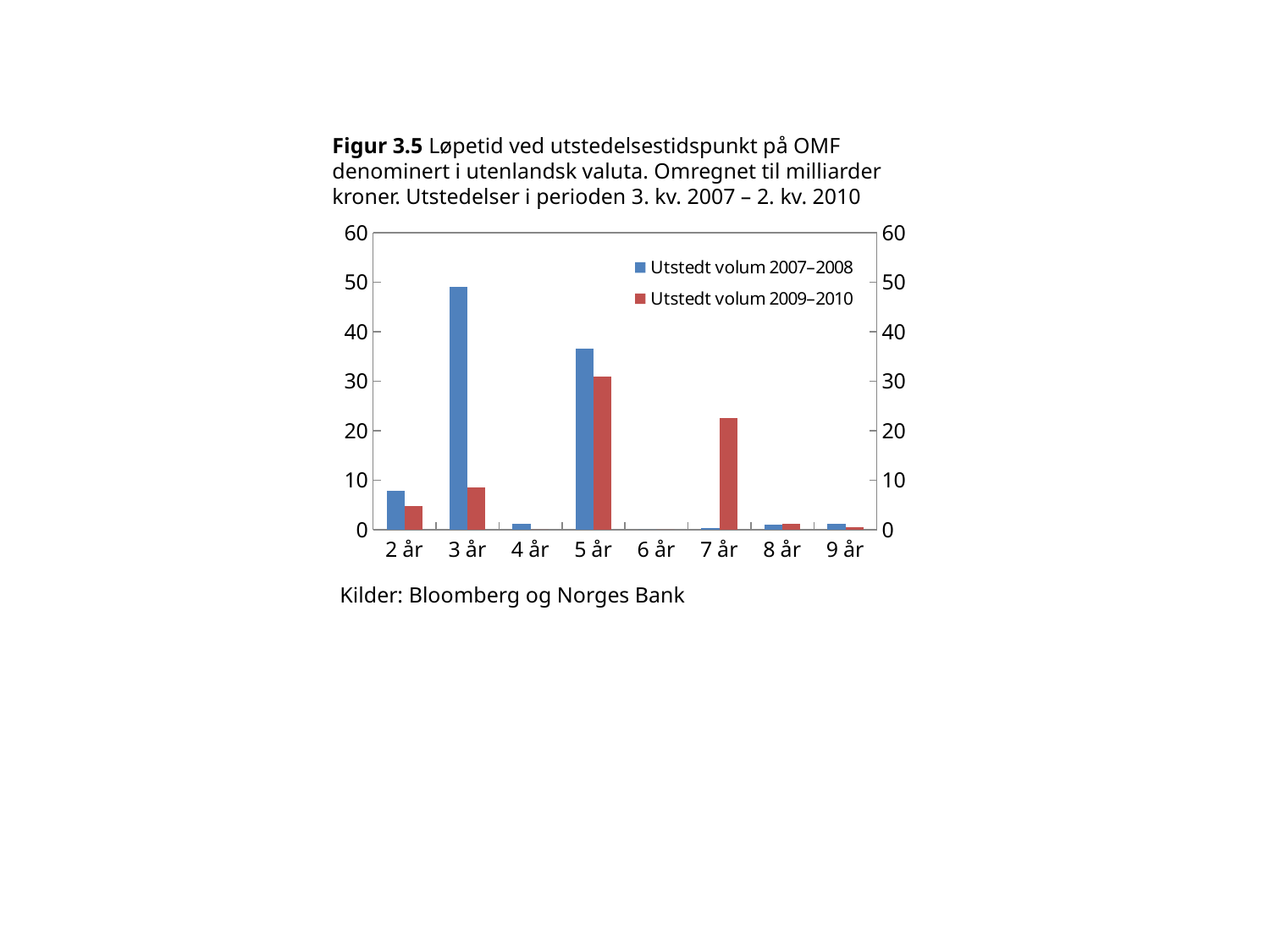
What sources are cited below the chart? Bloomberg og Norges Bank Is the value for 3 år in the Utstedt volum 2007–2008 series greater or less than 40? greater How many maturity categories are shown on the x axis? 8 Is the value for 3 år in the Utstedt volum 2009–2010 series greater or less than 10? less Which maturity has the highest value for Utstedt volum 2009–2010? 5 år For 7 år, which series has the larger value: Utstedt volum 2007–2008 or Utstedt volum 2009–2010? Utstedt volum 2009–2010 How many series does the legend list? 2 For 5 år, which series has the larger value: Utstedt volum 2007–2008 or Utstedt volum 2009–2010? Utstedt volum 2007–2008 What kind of chart is shown on the slide? bar chart Is the value for 2 år in the Utstedt volum 2007–2008 series greater or less than 10? less Which maturity has the highest value for Utstedt volum 2007–2008? 3 år